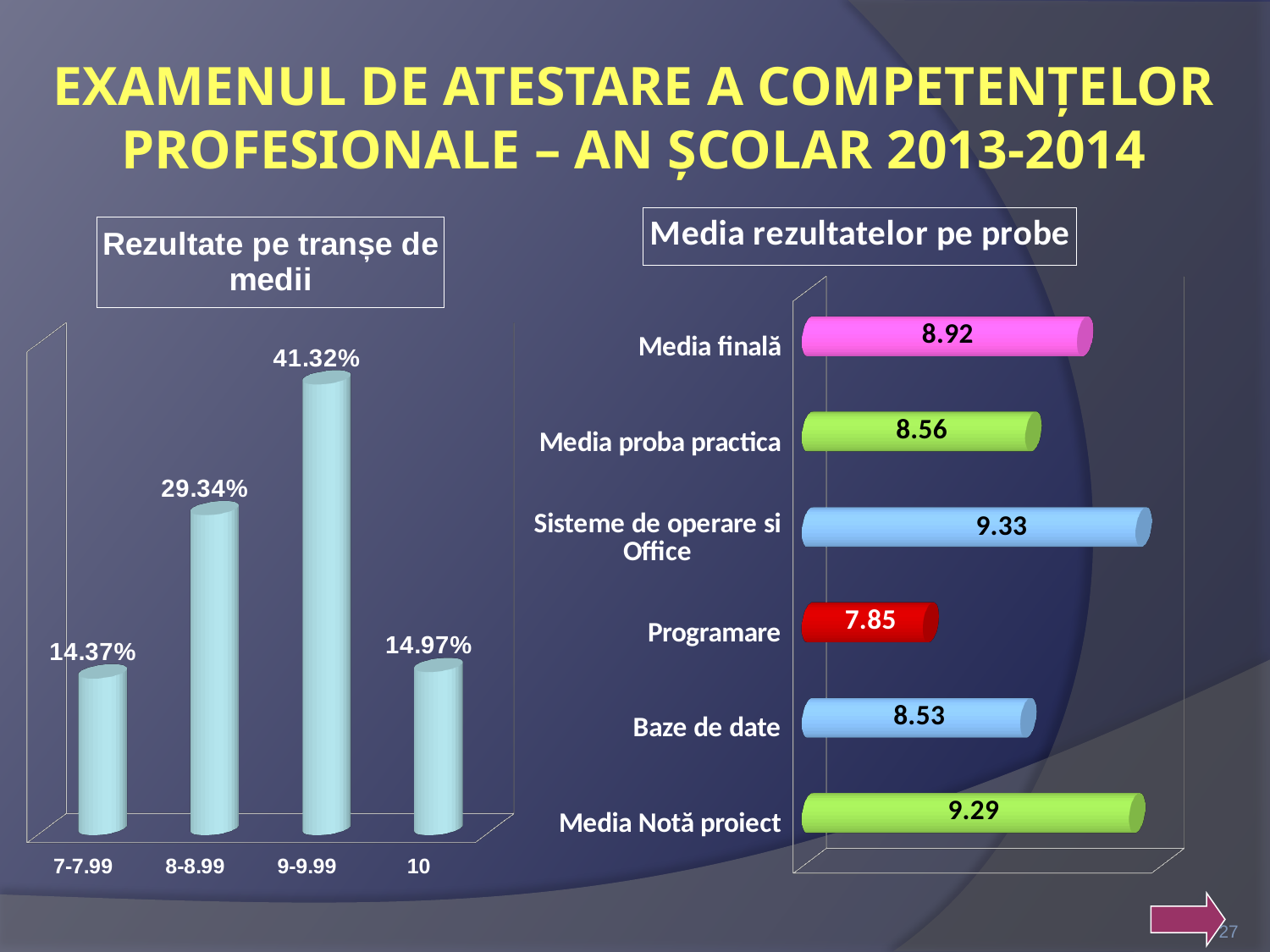
In the 'Media rezultatelor pe probe' chart, what is the value for Media finală? 8.92 In the 'Rezultate pe tranșe de medii' chart, what is the difference between the values for 9-9.99 and 8-8.99? 11.98% In the 'Rezultate pe tranșe de medii' chart, how many categories are shown? 4 In the 'Rezultate pe tranșe de medii' chart, what is the value for the 9-9.99 category? 41.32% What type of chart is the 'Media rezultatelor pe probe' chart? Bar chart In the 'Media rezultatelor pe probe' chart, what is the value for Programare? 7.85 In the 'Rezultate pe tranșe de medii' chart, which is larger, the value for 10 or the value for 7-7.99? 10 In the 'Media rezultatelor pe probe' chart, how many categories are shown? 6 In the 'Media rezultatelor pe probe' chart, which category has the highest value? Sisteme de operare si Office In the 'Rezultate pe tranșe de medii' chart, what is the value for the 8-8.99 category? 29.34% In the 'Media rezultatelor pe probe' chart, what is the difference between the values for Sisteme de operare si Office and Programare? 1.48 In the 'Rezultate pe tranșe de medii' chart, which category has the lowest value? 7-7.99